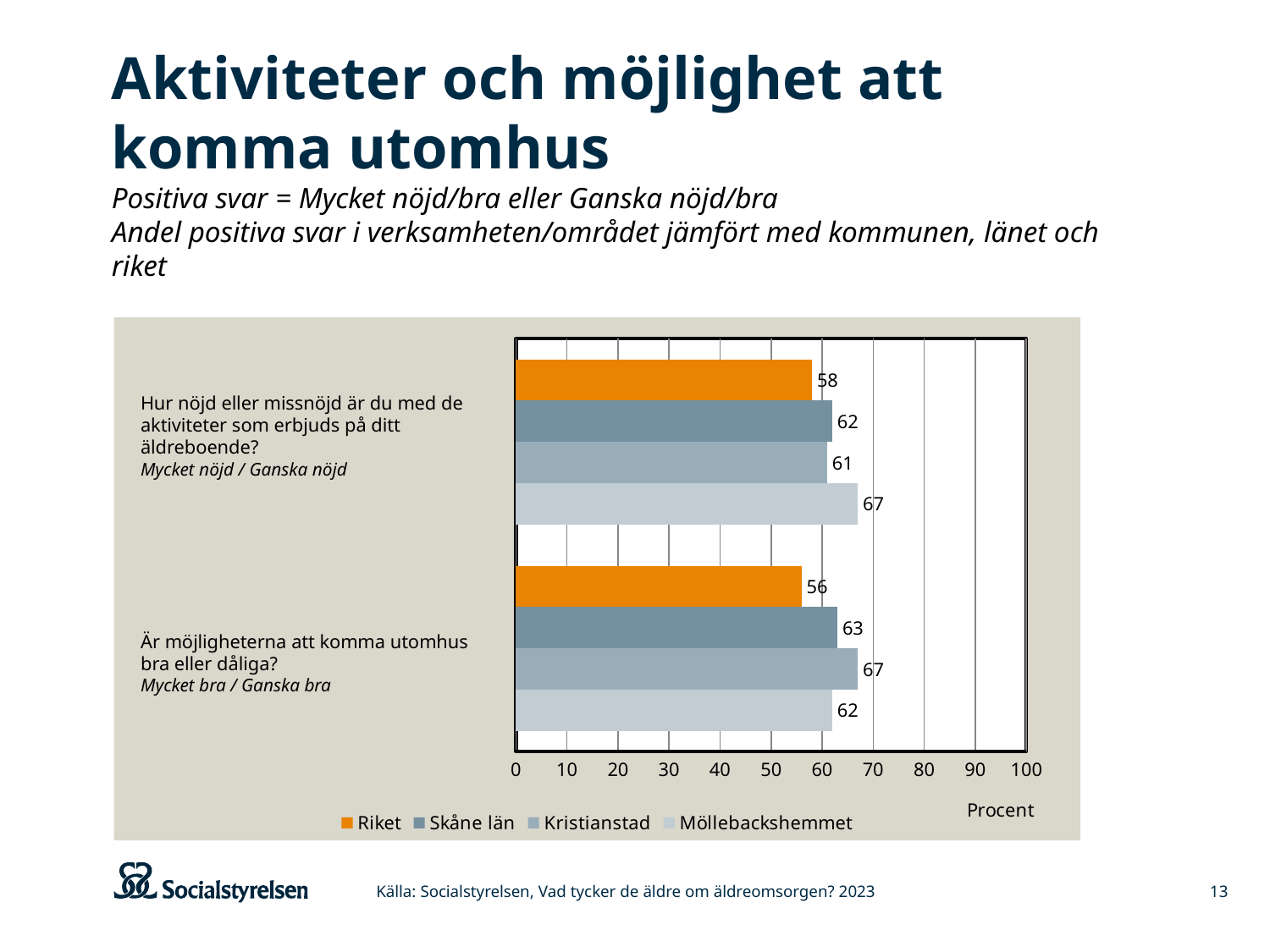
How many series does the legend list? 4 Which series has the lowest value for the question about opportunities to get outdoors? Riket What is the value for Riket for the question about opportunities to get outdoors (Är möjligheterna att komma utomhus bra eller dåliga?)? 56 For the question about opportunities to get outdoors, which is larger: the value for Kristianstad or the value for Möllebackshemmet? Kristianstad What is the difference between Möllebackshemmet and Riket for the question about activities offered at the care home? 9 What is the value for Skåne län for the question about activities offered at the care home? 62 How many question categories are shown on the y axis of the chart? 2 Which series has the highest value for the question about activities offered at the care home? Möllebackshemmet What is the value for Kristianstad for the question about opportunities to get outdoors? 67 What kind of chart is shown on the slide? Bar chart What is the value for Möllebackshemmet for the question about activities offered at the care home (Hur nöjd eller missnöjd är du med de aktiviteter som erbjuds på ditt äldreboende?)? 67 What label is shown on the x axis of the chart? Procent